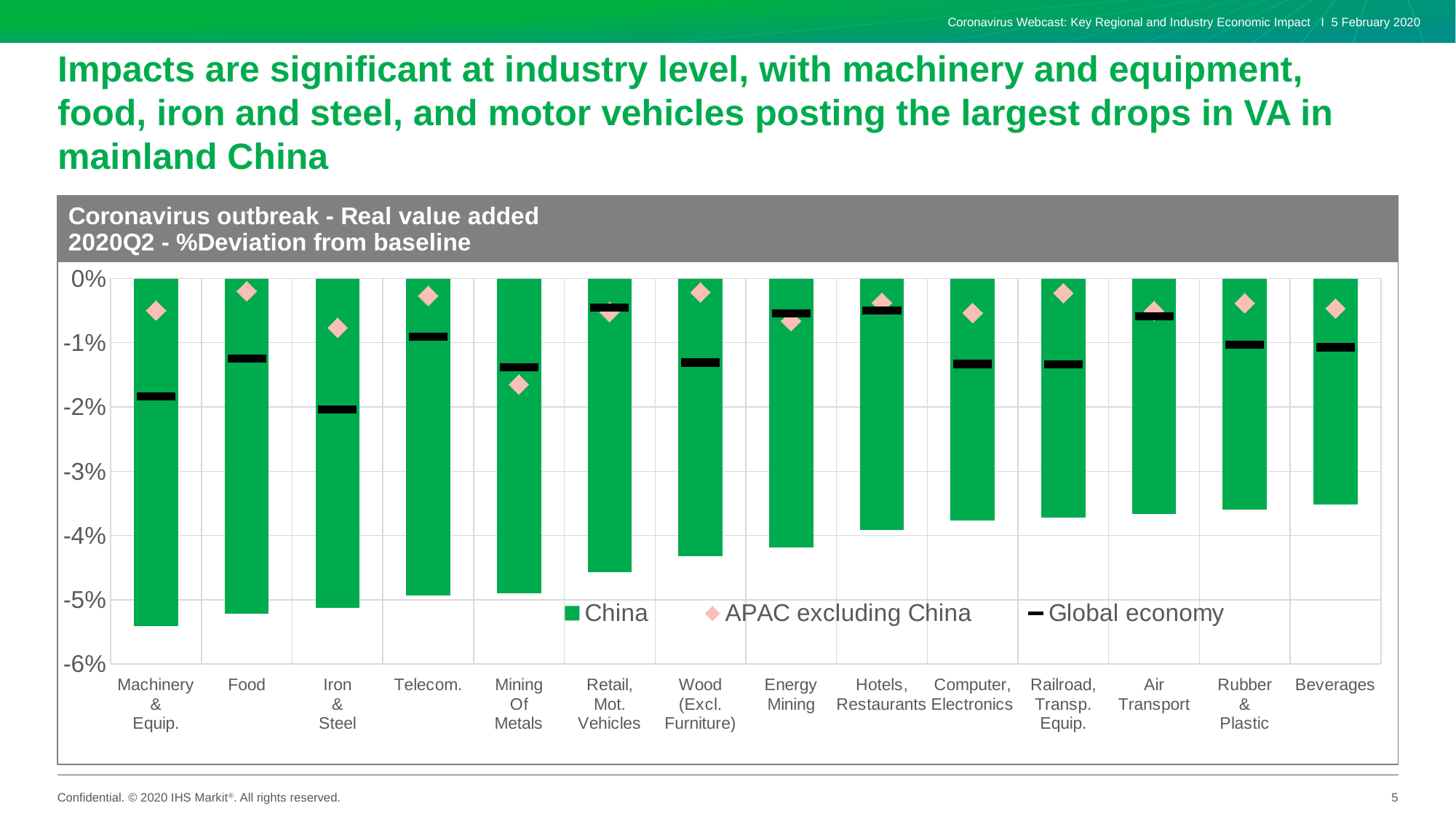
How many industry categories are shown on the x axis? 14 Which industry has the largest drop (most negative China bar)? Machinery & Equip. Which has the larger drop in China value added, Food or Telecom.? Food What kind of chart is shown on the slide? Bar chart Is the China value for Energy Mining greater or less than -5%? greater Is the China value for Food greater or less than -5%? less How many series does the legend list? 3 Is the China value for Retail, Mot. Vehicles greater or less than -4%? less Which has the larger drop in China value added, Machinery & Equip. or Beverages? Machinery & Equip. What is the title of the chart? Coronavirus outbreak - Real value added 2020Q2 - %Deviation from baseline Which series is represented by the pink diamond markers? APAC excluding China